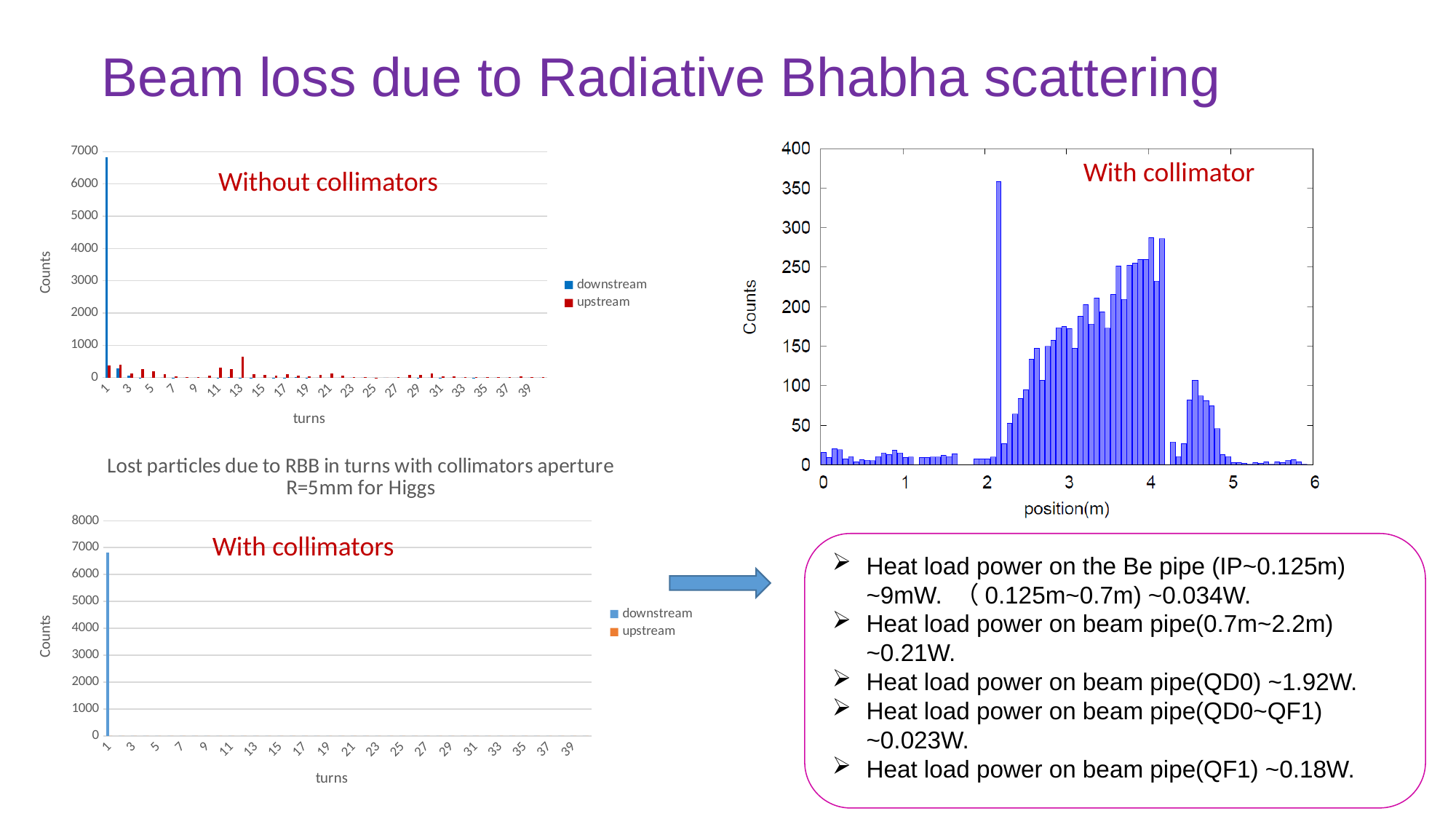
In the bottom-left 'With collimators' chart, is the downstream value at turn 1 greater or less than 7000? less In the 'Without collimators' chart, is the upstream value at turn 13 greater or less than 1000? less How many series does the legend of the 'Without collimators' chart list? 2 In the 'Without collimators' chart, which series has the taller bar at turn 1, downstream or upstream? downstream What is the x-axis label of the 'With collimator' histogram on the right? position(m) In the 'Without collimators' chart, at which turn is the downstream count highest? 1 In the 'With collimator' histogram on the right, is the tallest bar (near position 2.1 m) greater or less than 300? greater How many series does the legend of the bottom-left 'With collimators' chart list? 2 What kind of chart is the 'Without collimators' chart on the top left? bar chart What is the title printed above the bottom-left 'With collimators' chart? Lost particles due to RBB in turns with collimators aperture R=5mm for Higgs